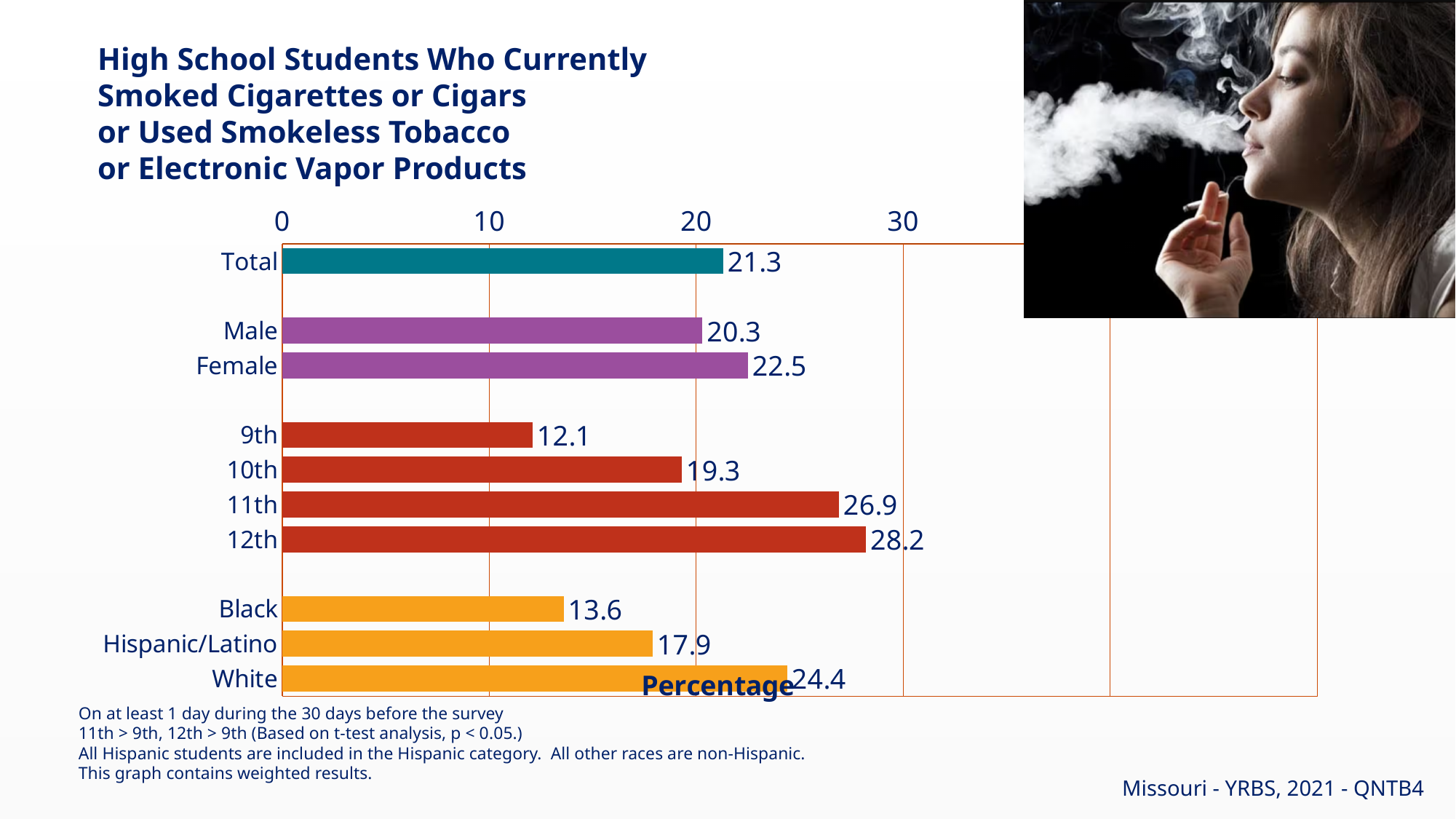
What is the value for 9th grade? 12.1 What is the difference between the values for 12th and 9th? 16.1 What is the label of the x axis? Percentage What is the value for Female? 22.5 What kind of chart is shown on the slide? bar chart What is the value for Total? 21.3 What is the value for Hispanic/Latino? 17.9 Is the value for White greater or less than 20? greater How many categories are shown in the chart? 10 Which category has the highest value? 12th Which category has the lowest value? 9th Which is larger, the value for Male or the value for Female? Female